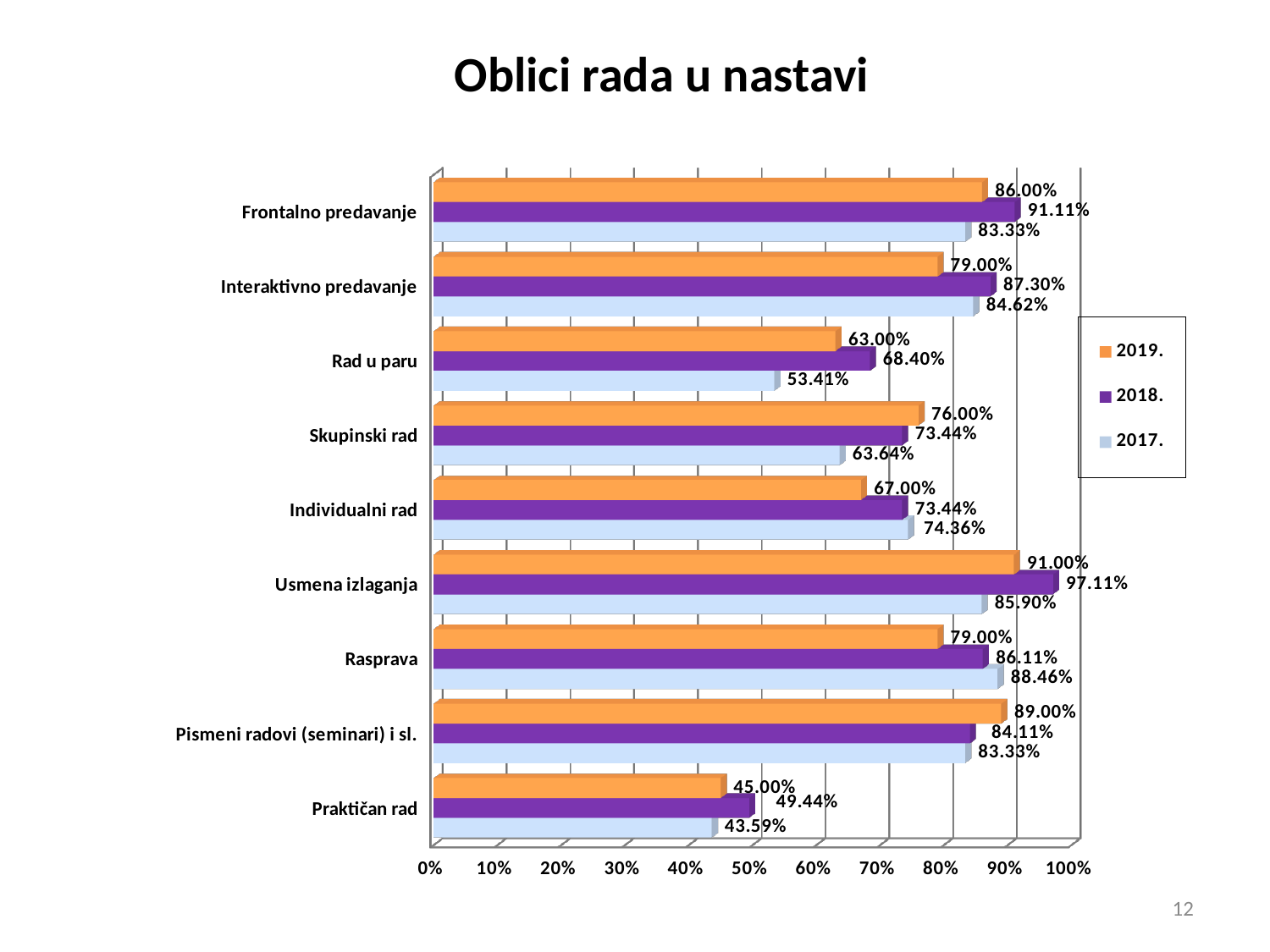
What is the title of the chart? Oblici rada u nastavi Is the 2017. value for Rad u paru greater or less than 60%? less What is the 2018. value for Pismeni radovi (seminari) i sl.? 84.11% What is the 2017. value for Rasprava? 88.46% How many series does the legend list? 3 What kind of chart is shown on the slide? bar chart Which category has the lowest 2017. value? Praktičan rad What is the difference between the 2018. and 2019. values for Frontalno predavanje? 5.11% For Skupinski rad, which is larger: the 2019. value or the 2017. value? 2019. How many categories are shown on the chart? 9 What is the 2019. value for Rad u paru? 63.00% Which category has the highest 2018. value? Usmena izlaganja